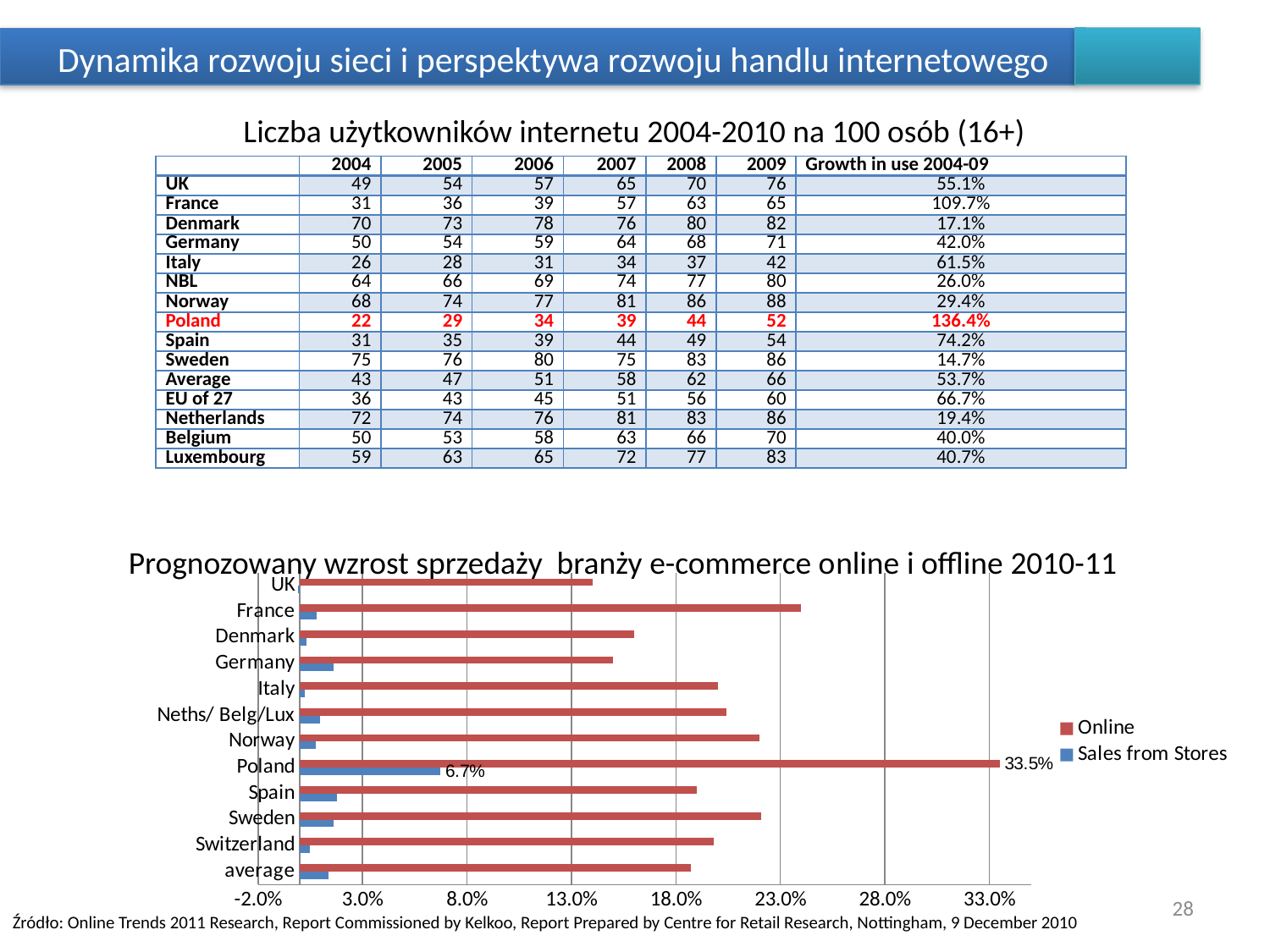
In the bar chart, which category has the highest Sales from Stores value? Poland In the bar chart, what is the Online value for Poland? 33.5% In the bar chart, is the Online value for UK greater or less than 18.0%? less In the bar chart, which colour represents the Online series? red In the bar chart, what is the Sales from Stores value for Poland? 6.7% In the bar chart, is the Online value for France larger or smaller than the Online value for Denmark? larger How many categories are plotted on the bar chart? 12 How many series does the legend of the bar chart list? 2 In the bar chart, which category has the highest Online value? Poland In the bar chart, is the Online value for Poland greater or less than 28.0%? greater What kind of chart is shown at the bottom of the slide? bar chart In the bar chart, what is the difference between Poland's Online value and its Sales from Stores value? 26.8%